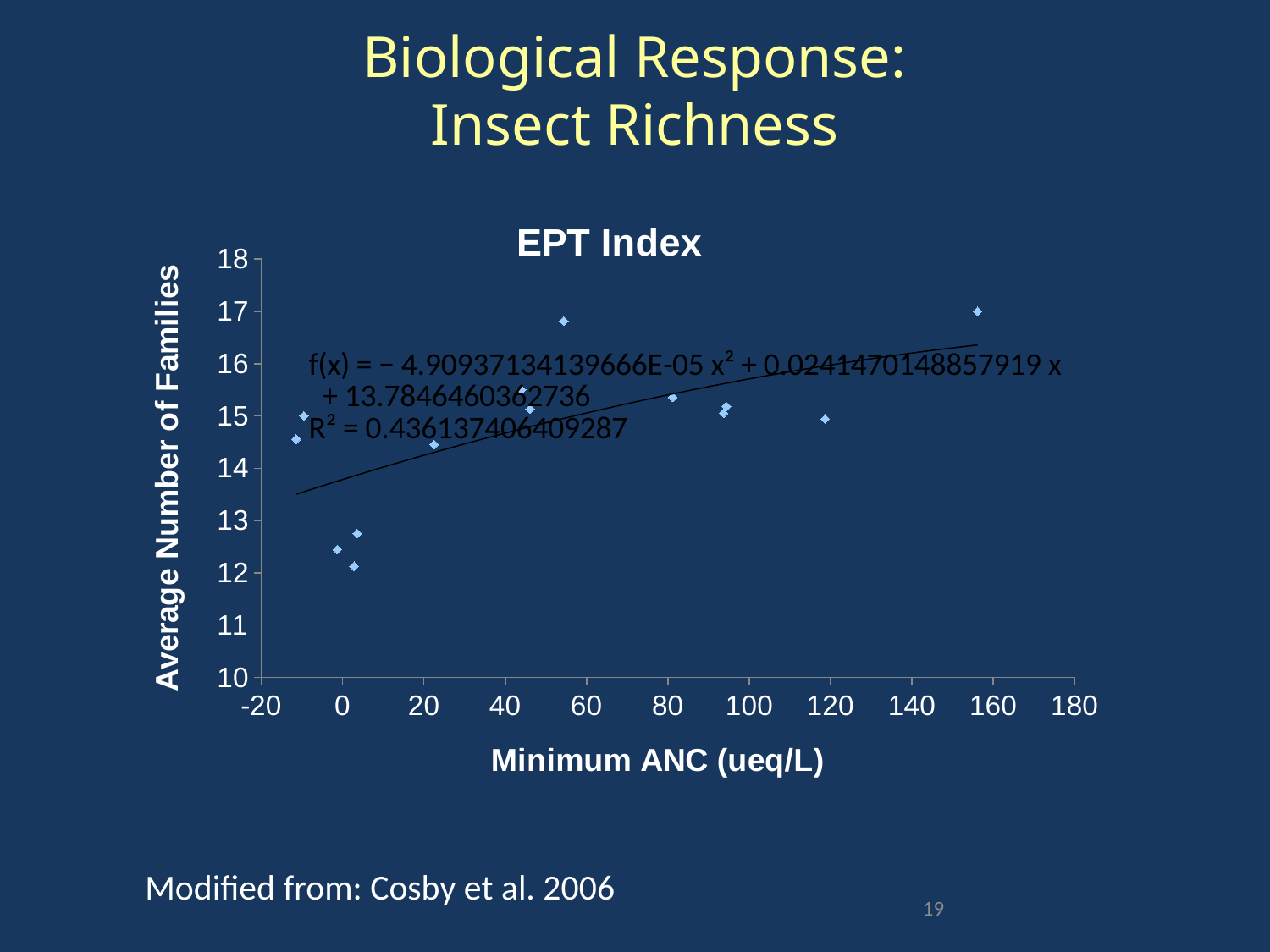
Is the value for the point at a Minimum ANC of about 156 ueq/L greater or less than 16? greater What is the constant term (intercept) in the fitted equation f(x) printed on the chart? 13.7846460362736 What kind of chart is shown on the slide? scatter chart According to the fitted trendline, does the Average Number of Families generally rise or fall as Minimum ANC increases? rise What is the label of the x axis of the chart? Minimum ANC (ueq/L) Which is larger: the value for the point at a Minimum ANC of about 54 ueq/L or the value for the point at about 118 ueq/L? the point at about 54 ueq/L What R² value is printed on the chart for the fitted trendline? 0.436137406409287 What is the title of the chart? EPT Index Is the lowest point on the chart, near a Minimum ANC of about 3 ueq/L, greater or less than 13? less Is the value for the point at a Minimum ANC of about 54 ueq/L greater or less than 16? greater